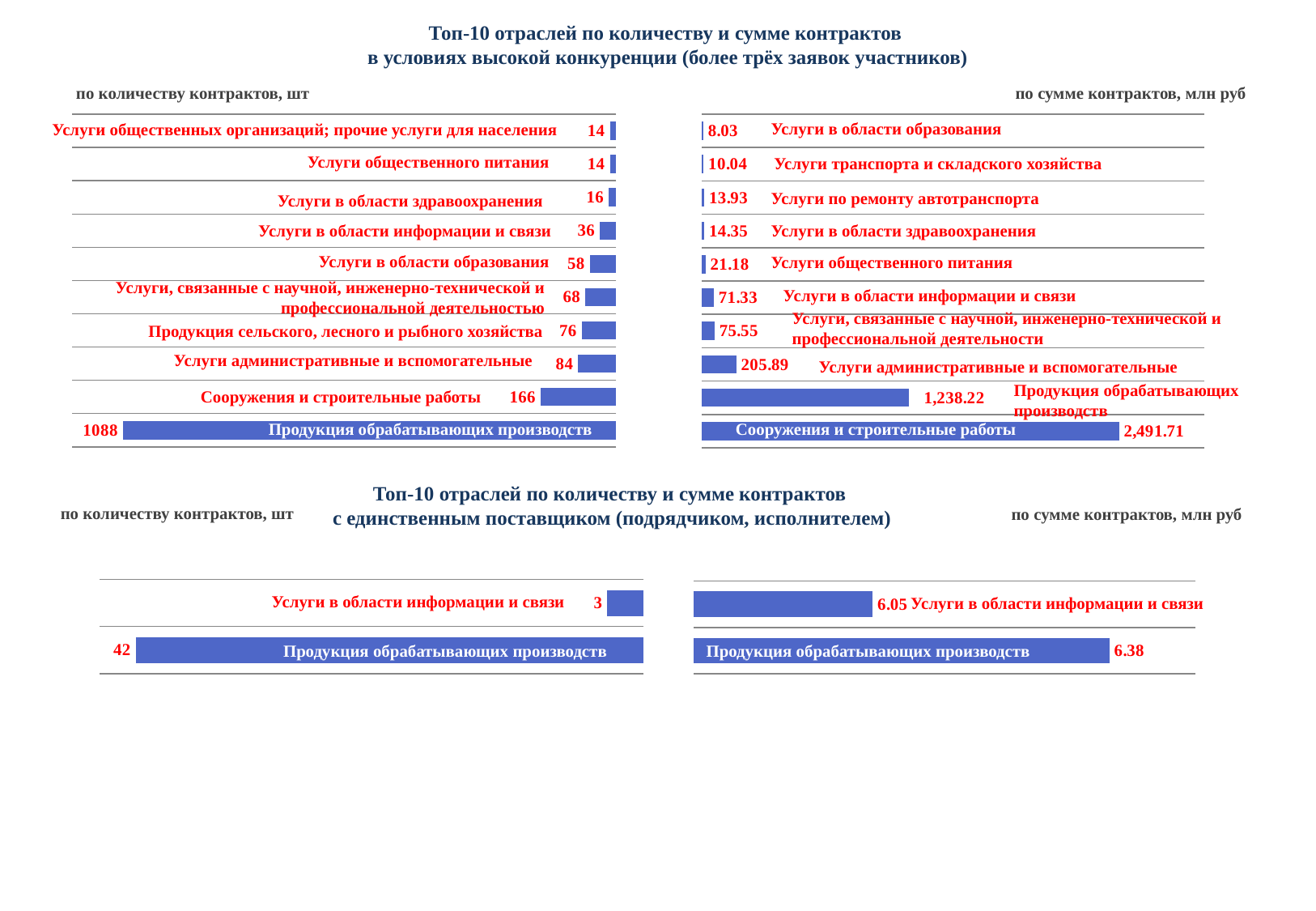
In the top-left chart (по количеству контрактов, шт, high competition), which category has the highest value? Продукция обрабатывающих производств In the top-right chart (по сумме контрактов, млн руб, high competition), what is the value for Услуги административные и вспомогательные? 205.89 In the top-left chart (по количеству контрактов, шт, high competition), what is the difference between Услуги административные и вспомогательные and Продукция сельского, лесного и рыбного хозяйства? 8 In the top-left chart (по количеству контрактов, шт, high competition), what is the value for Сооружения и строительные работы? 166 What type of chart is used in the bottom-left chart (по количеству контрактов, шт, single supplier)? Bar chart In the bottom-right chart (по сумме контрактов, млн руб, single supplier), what is the difference between Продукция обрабатывающих производств and Услуги в области информации и связи? 0.33 In the bottom-left chart (по количеству контрактов, шт, single supplier), what is the value for Продукция обрабатывающих производств? 42 What is the title of the lower pair of charts on the slide? Топ-10 отраслей по количеству и сумме контрактов с единственным поставщиком (подрядчиком, исполнителем) In the top-right chart (по сумме контрактов, млн руб, high competition), which category has the lowest value? Услуги в области образования In the top-right chart (по сумме контрактов, млн руб, high competition), which is larger: Услуги в области информации и связи or Услуги общественного питания? Услуги в области информации и связи In the top-right chart (по сумме контрактов, млн руб, high competition), what is the value for Сооружения и строительные работы? 2,491.71 In the top-left chart (по количеству контрактов, шт, high competition), how many categories are shown? 10